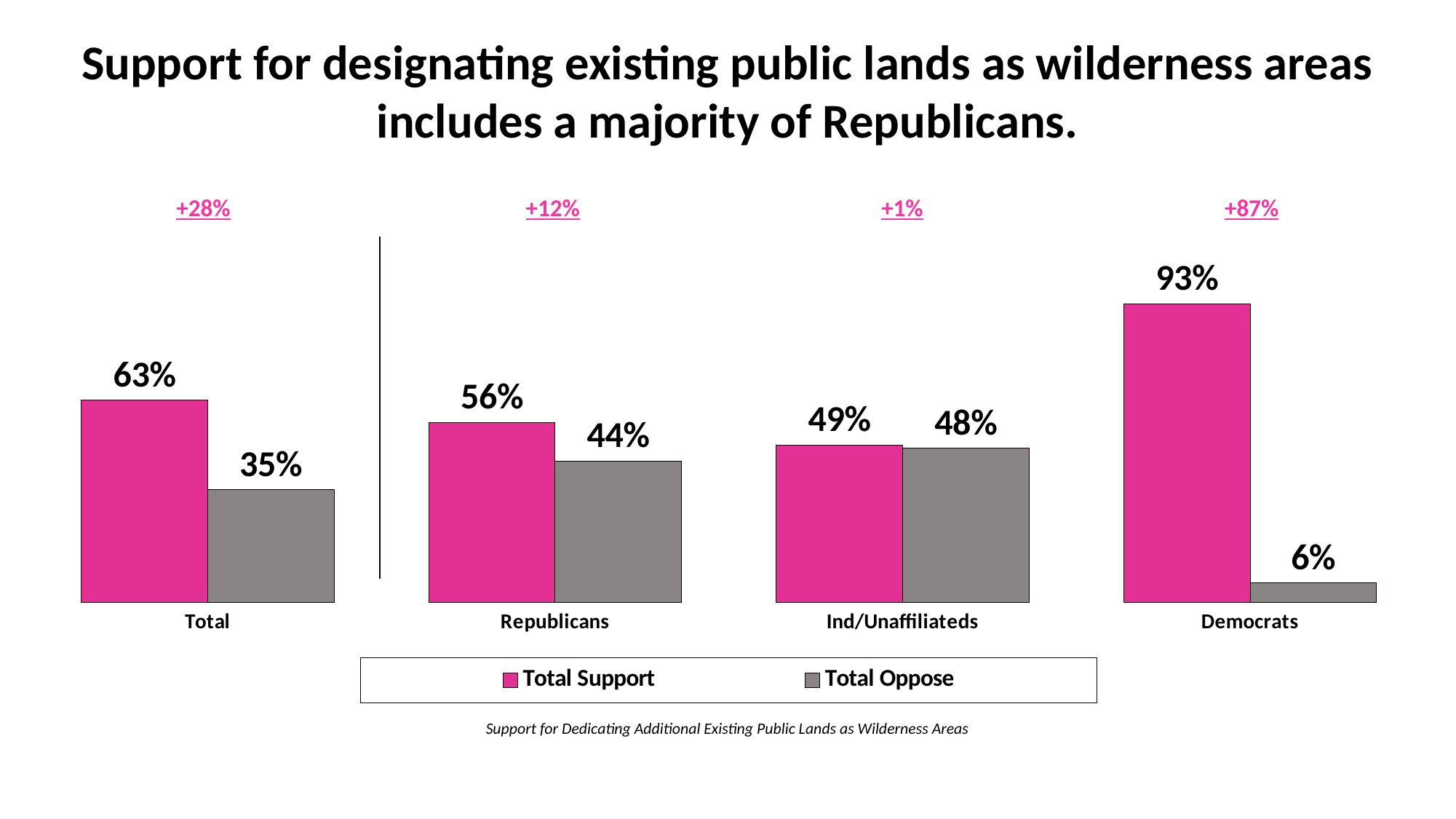
What is the Total Support value for Republicans? 56% What is the Total Support value for Ind/Unaffiliateds? 49% Which is larger for Republicans, Total Support or Total Oppose? Total Support How many categories are shown on the x axis? 4 Which category has the lowest Total Oppose value? Democrats What is the difference between Total Support and Total Oppose for the Total category? 28% What colour represents Total Oppose in the legend? Gray What is the Total Oppose value for Democrats? 6% What net margin is shown above the Democrats bars? +87% How many series does the legend list? 2 Which category has the highest Total Support value? Democrats What kind of chart is shown on the slide? Bar chart